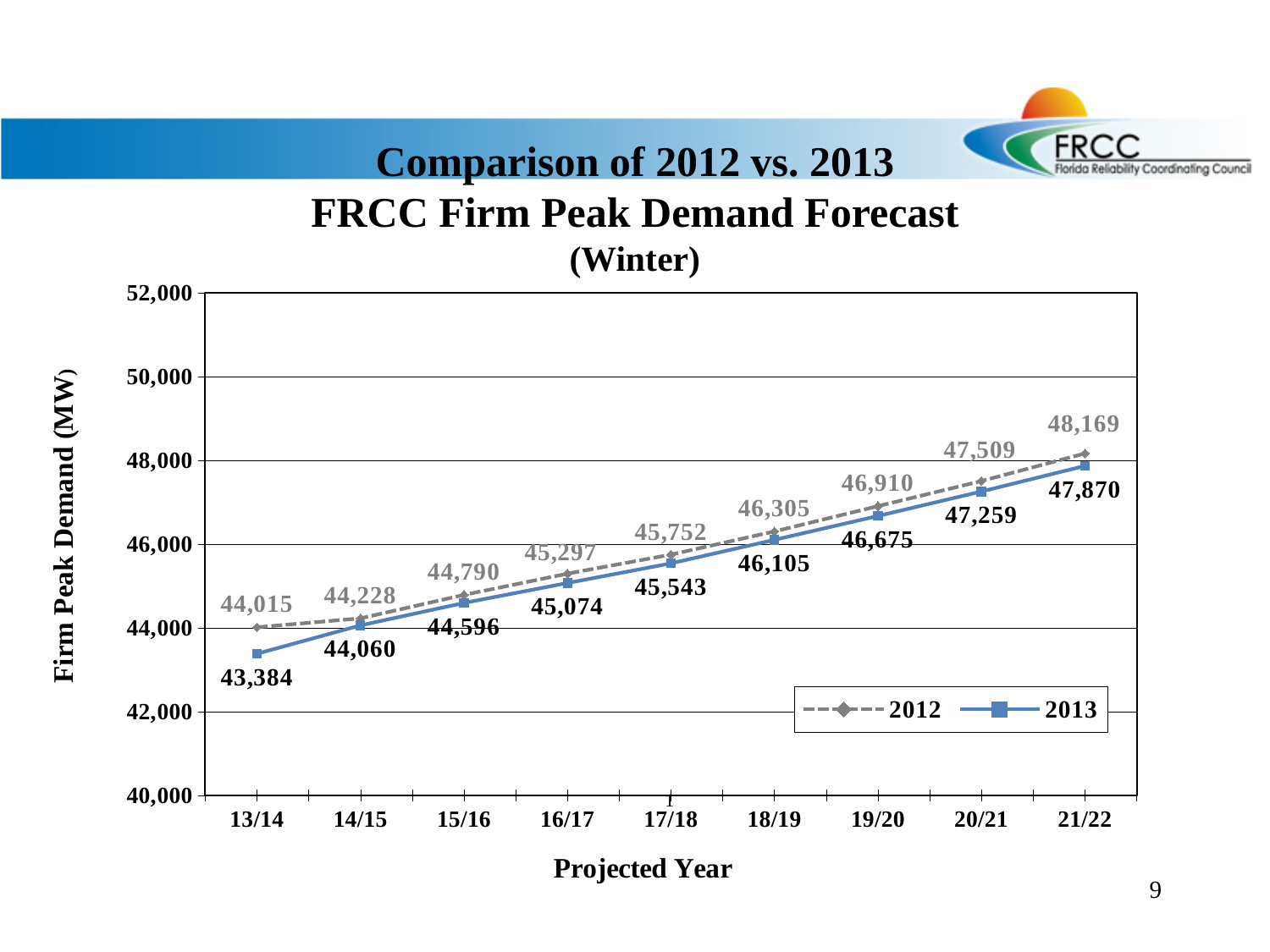
Which projected year has the highest 2013 forecast value? 21/22 What is the 2012 forecast value for 15/16? 44,790 What kind of chart is shown? line chart What is the 2013 forecast value for 13/14? 43,384 How many projected years are shown on the x axis? 9 Which projected year has the lowest 2012 forecast value? 13/14 Which is larger for 20/21, the 2012 forecast or the 2013 forecast? 2012 What is the 2012 forecast value for 21/22? 48,169 How many series does the legend list? 2 What is the 2013 forecast value for 18/19? 46,105 Do the 2013 forecast values rise or fall from 13/14 to 21/22? rise What is the difference between the 2012 and 2013 forecast values for 13/14? 631